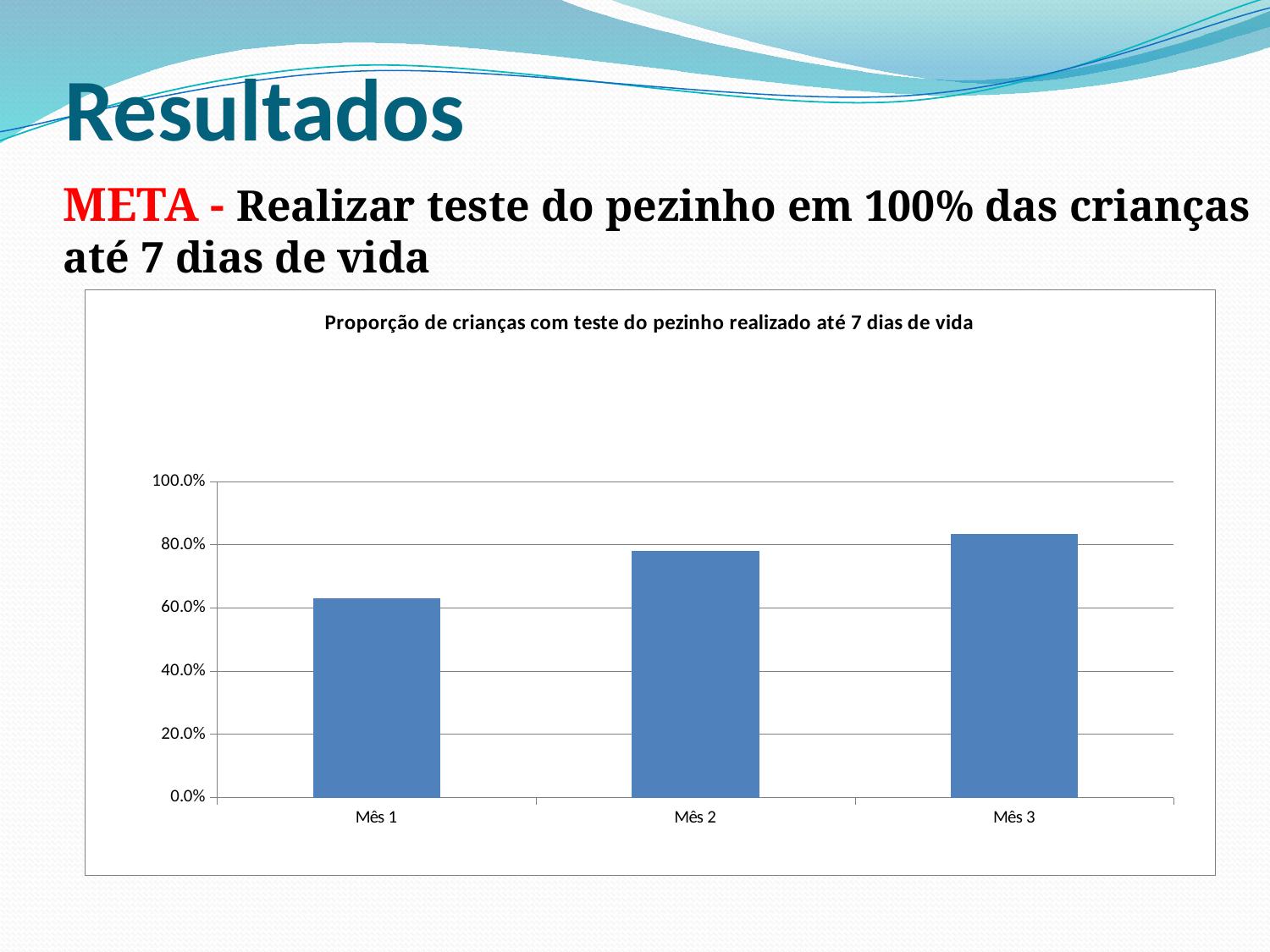
What kind of chart is shown on the slide? bar chart What is the title of the chart? Proporção de crianças com teste do pezinho realizado até 7 dias de vida Which month has the lowest proportion in the chart? Mês 1 Which is larger, the value for Mês 2 or the value for Mês 3? Mês 3 How many categories (months) are plotted in the chart? 3 Which is larger, the value for Mês 1 or the value for Mês 2? Mês 2 Which month has the highest proportion of children with the heel prick test done within 7 days? Mês 3 Is the value for Mês 3 greater or less than 100.0%? less Do the values rise or fall from Mês 1 to Mês 3? rise Is the value for Mês 3 greater or less than 80.0%? greater Is the value for Mês 2 greater or less than 60.0%? greater